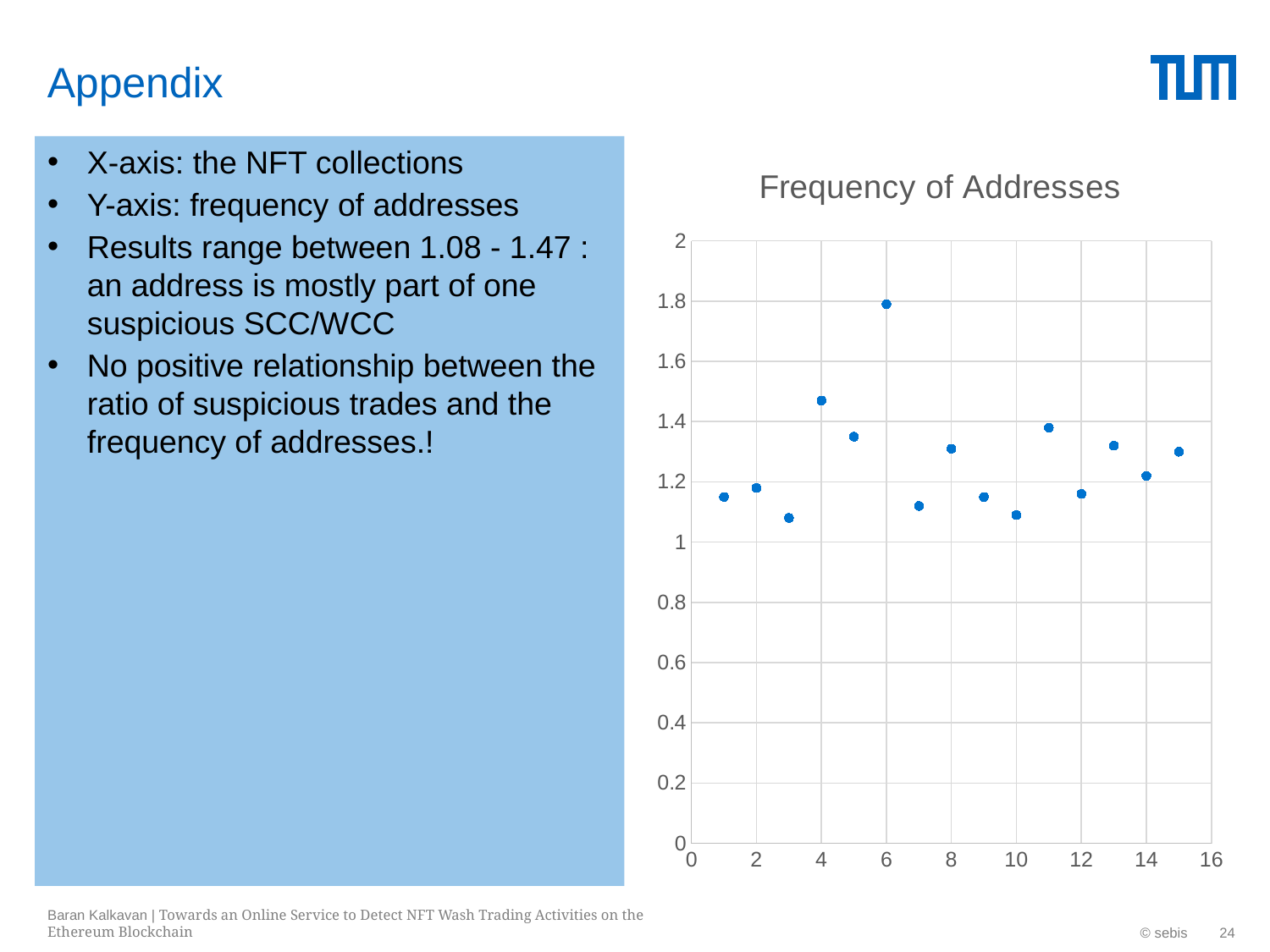
Is the value at x = 3 greater or less than 1.2? less Is the value at x = 8 greater or less than 1.2? greater What is the title of the chart? Frequency of Addresses Is the value at x = 6 greater or less than 1.6? greater Which has the larger value, the point at x = 11 or the point at x = 10? x = 11 What kind of chart is shown on the slide? scatter chart What is the maximum value shown on the y axis? 2 How many data points are plotted in the chart? 15 Which has the larger value, the point at x = 6 or the point at x = 4? x = 6 At which x value does the chart reach its highest point? 6